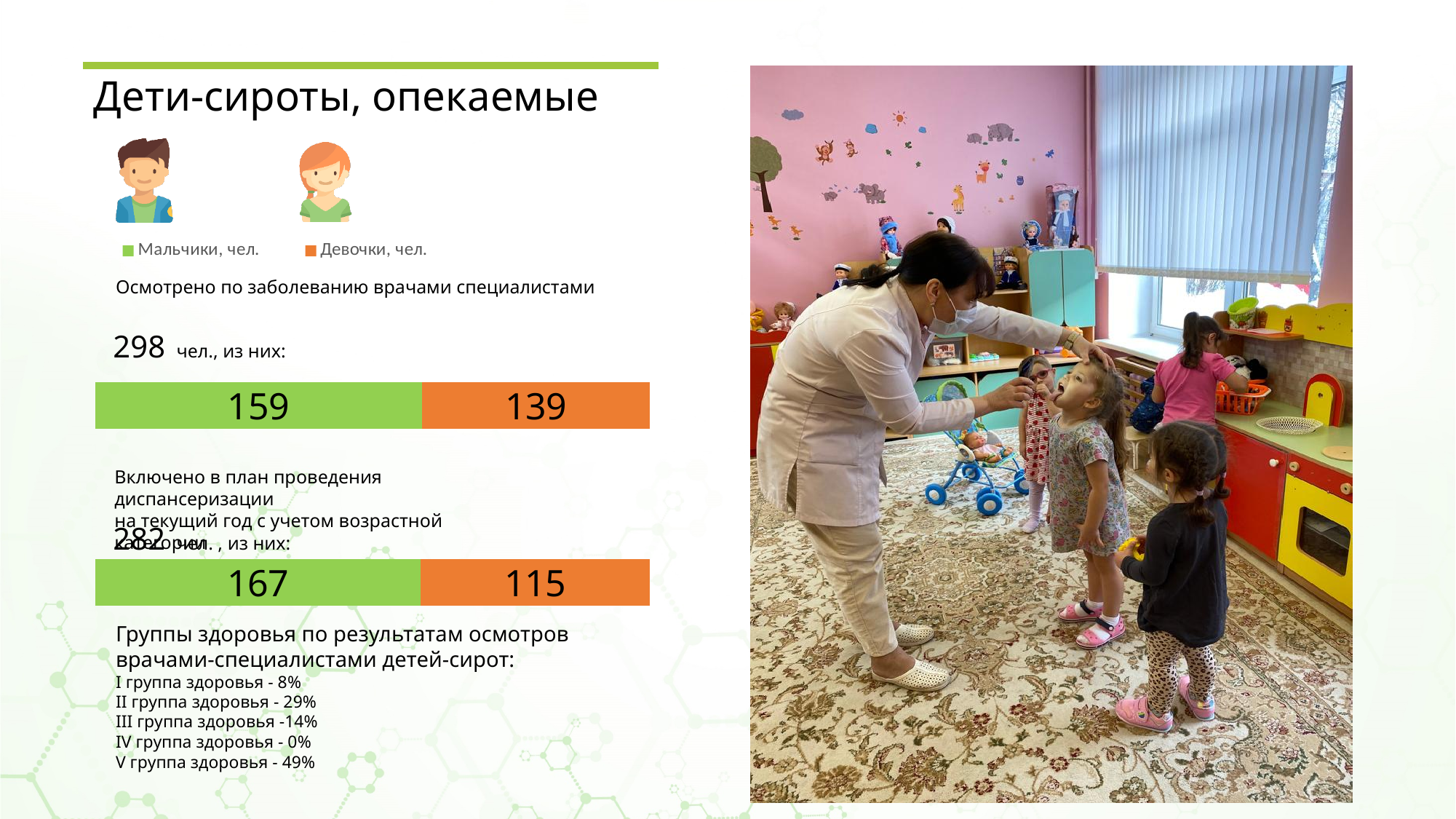
In the lower bar chart, which is larger: the value for Мальчики or for Девочки? Мальчики What type of chart is used to show the Мальчики and Девочки values on the slide? Bar chart In the upper bar chart (Осмотрено по заболеванию врачами специалистами), what is the value for Девочки, чел.? 139 In the lower bar chart, what is the difference between the values for Мальчики and Девочки? 52 In the lower bar chart (Включено в план проведения диспансеризации), what is the value for Мальчики, чел.? 167 Which colour represents Девочки, чел. in the legend? Orange In the upper bar chart (Осмотрено по заболеванию врачами специалистами), what is the value for Мальчики, чел.? 159 In the upper bar chart, what is the difference between the values for Мальчики and Девочки? 20 How many series does the legend list for the bar charts? 2 In the upper bar chart, what is the total of the stacked bar (Мальчики plus Девочки)? 298 In the lower bar chart, what is the total of the stacked bar (Мальчики plus Девочки)? 282 In the lower bar chart (Включено в план проведения диспансеризации), what is the value for Девочки, чел.? 115